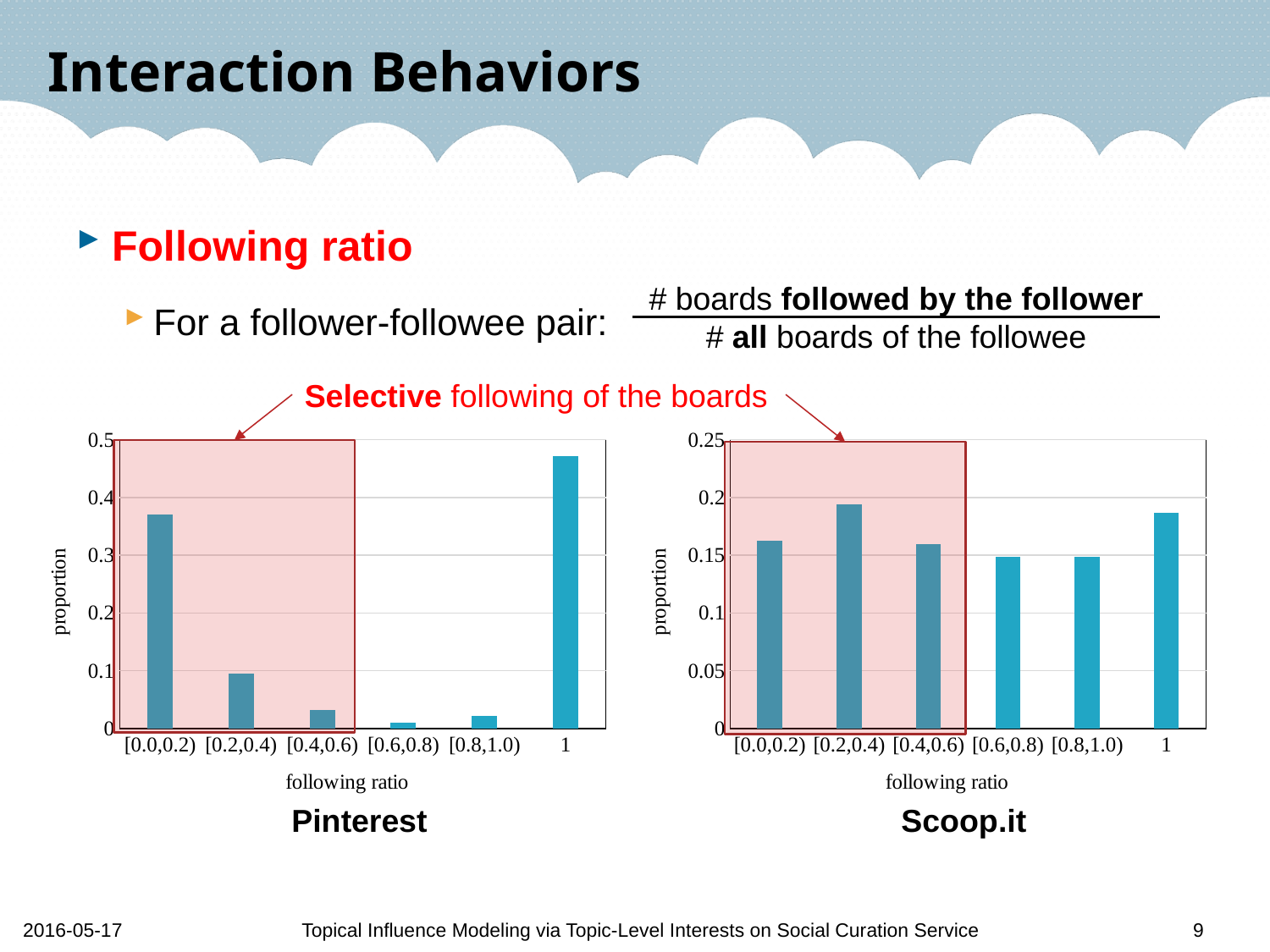
In the Pinterest chart, is the proportion for following ratio 1 greater or less than 0.4? greater In the Scoop.it chart, which following ratio category has the highest proportion? [0.2,0.4) In the Pinterest chart, which has the larger proportion, [0.0,0.2) or [0.2,0.4)? [0.0,0.2) In the Pinterest chart, which following ratio category has the highest proportion? 1 In the Pinterest chart, is the proportion for [0.0,0.2) greater or less than 0.3? greater In the Pinterest chart, is the proportion for [0.4,0.6) greater or less than 0.1? less In the Scoop.it chart, which has the larger proportion, [0.2,0.4) or [0.4,0.6)? [0.2,0.4) In the Pinterest chart, which following ratio category has the lowest proportion? [0.6,0.8) What type of chart is the Pinterest chart? bar chart How many following ratio categories are shown on the x axis of the Scoop.it chart? 6 What is the label of the y axis on the Scoop.it chart? proportion